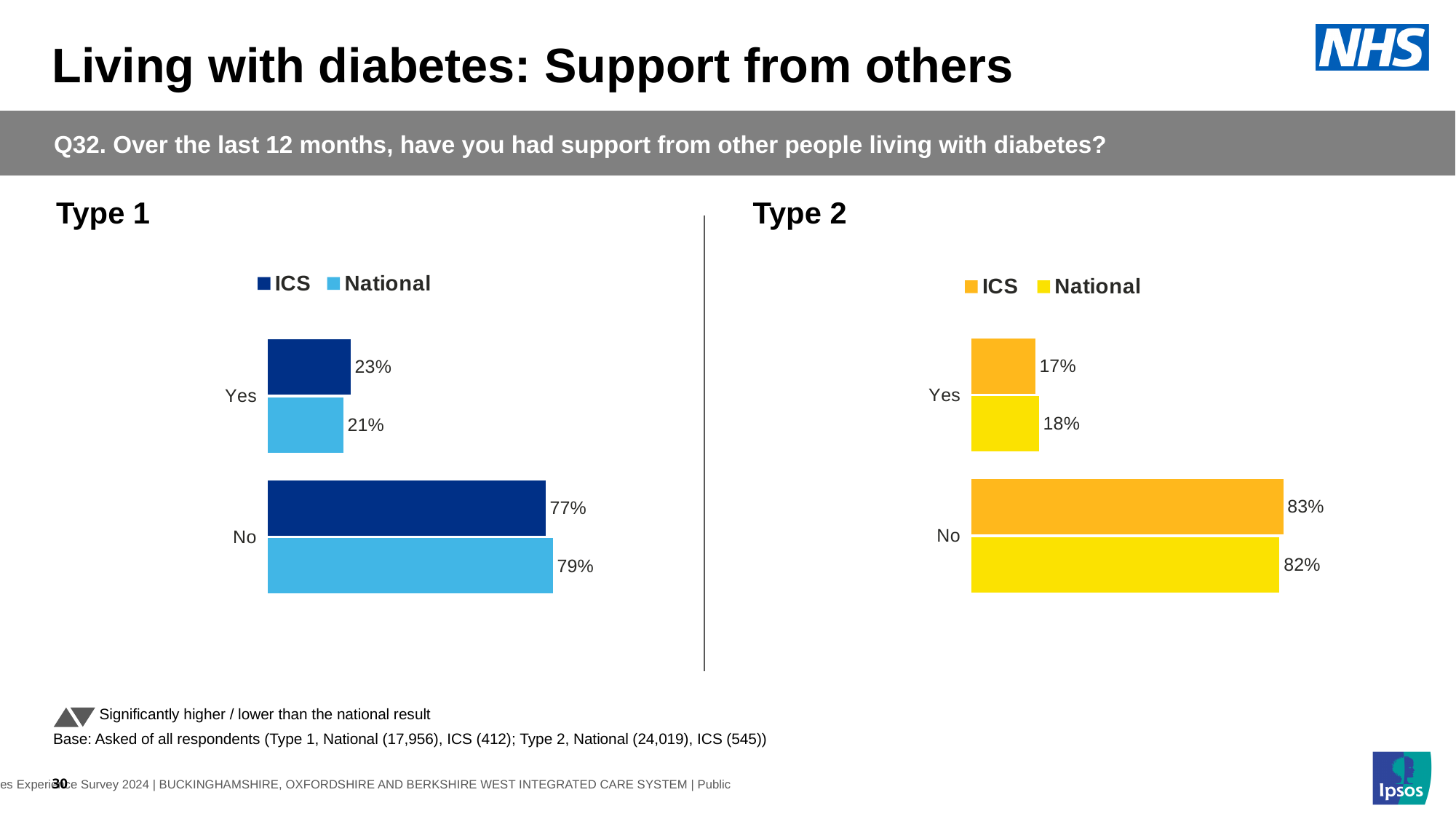
In the Type 1 chart, which is larger for Yes: the ICS value or the National value? ICS How many series does the legend of the Type 1 chart list? 2 In the Type 2 chart, what is the National value for Yes? 18% What kind of chart is the Type 2 chart? Bar chart In the Type 2 chart, what is the ICS value for No? 83% In the Type 2 chart, which is larger for No: the ICS value or the National value? ICS In the Type 2 chart, which response category has the highest ICS value? No In the Type 1 chart, what is the ICS value for Yes? 23% In the Type 2 chart, what is the difference between the National and ICS values for Yes? 1% In the Type 1 chart, what is the difference between the ICS and National values for No? 2% In the Type 1 chart, what is the National value for No? 79% In the Type 1 chart, which response category has the lowest National value? Yes